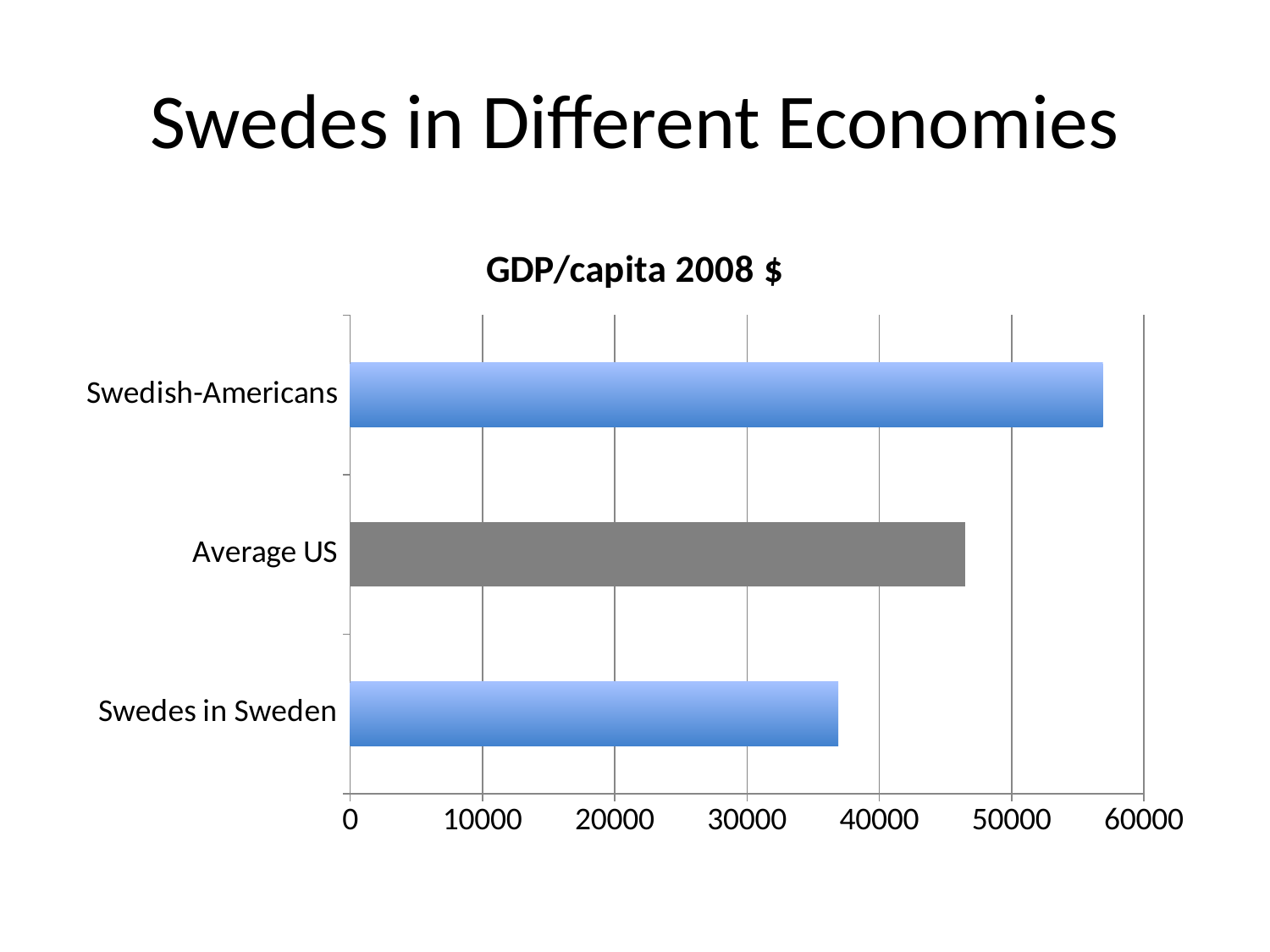
Is the value for Swedes in Sweden greater or less than 40000? less What is the title of the chart? GDP/capita 2008 $ Is the value for Average US greater or less than 40000? greater Which is larger, the value for Average US or the value for Swedes in Sweden? Average US How many categories are plotted in the chart? 3 Which category has the lowest GDP/capita? Swedes in Sweden Which category has the highest GDP/capita? Swedish-Americans Which is larger, the value for Swedish-Americans or the value for Average US? Swedish-Americans Is the value for Average US greater or less than 50000? less What kind of chart is shown on the slide? bar chart What is the maximum value shown on the horizontal axis? 60000